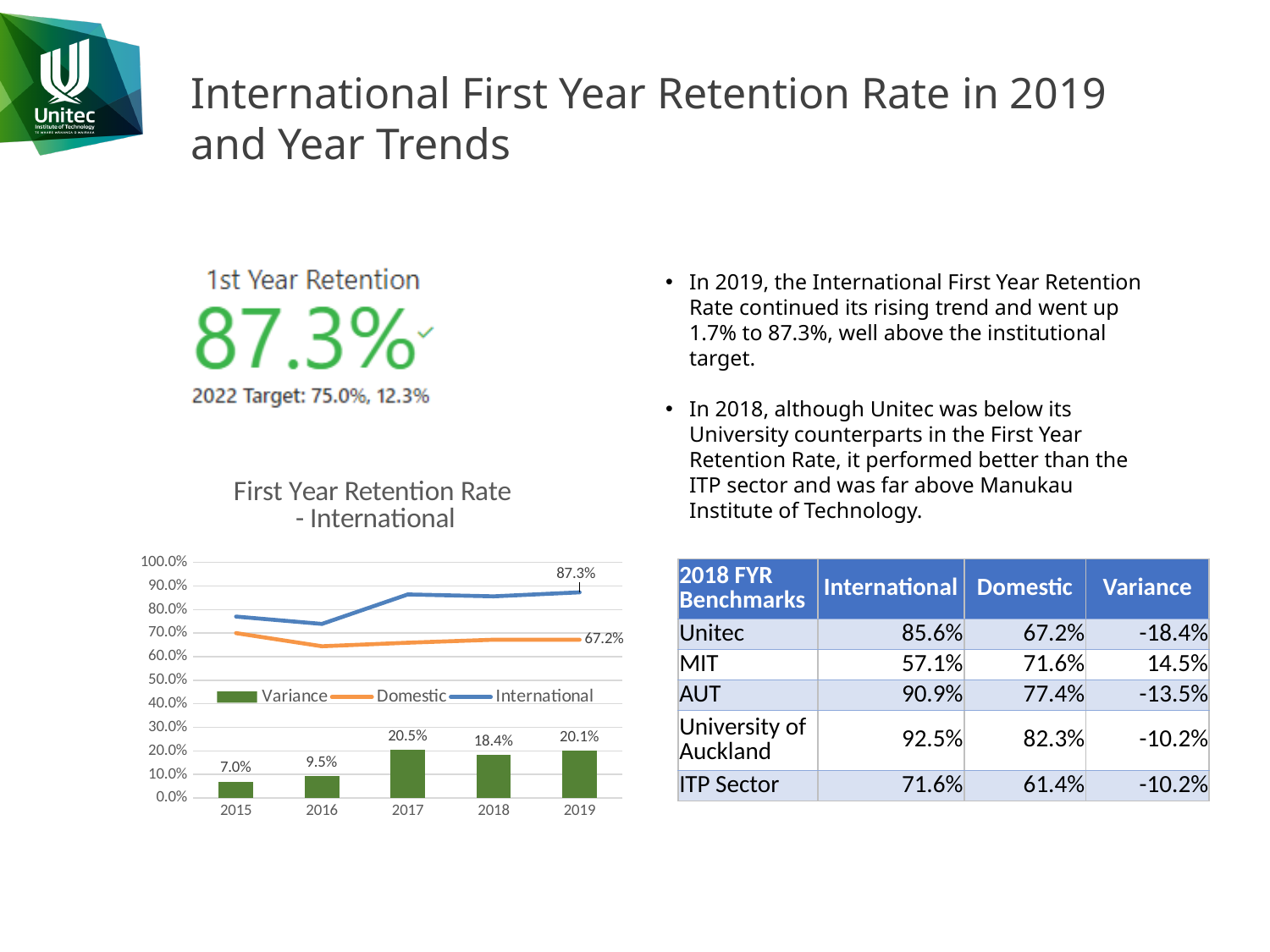
In the 'First Year Retention Rate - International' chart, what is the difference between the International and Domestic rates in 2019? 20.1% In the 'First Year Retention Rate - International' chart, what is the Variance value for 2017? 20.5% How many series does the legend of the 'First Year Retention Rate - International' chart list? 3 In the 'First Year Retention Rate - International' chart, what is the International retention rate in 2019? 87.3% In the 'First Year Retention Rate - International' chart, is the International value for 2016 greater or less than 80.0%? less How many years are shown on the x axis of the 'First Year Retention Rate - International' chart? 5 In the 'First Year Retention Rate - International' chart, what is the Domestic retention rate in 2019? 67.2% In the 'First Year Retention Rate - International' chart, by how much did the Variance increase from 2016 to 2017? 11.0% In the 'First Year Retention Rate - International' chart, which year has the lowest Variance? 2015 In the 'First Year Retention Rate - International' chart, is the Variance larger in 2018 or 2019? 2019 In the 'First Year Retention Rate - International' chart, does the Variance rise or fall from 2015 to 2017? rise In the 'First Year Retention Rate - International' chart, which year has the highest Variance? 2017